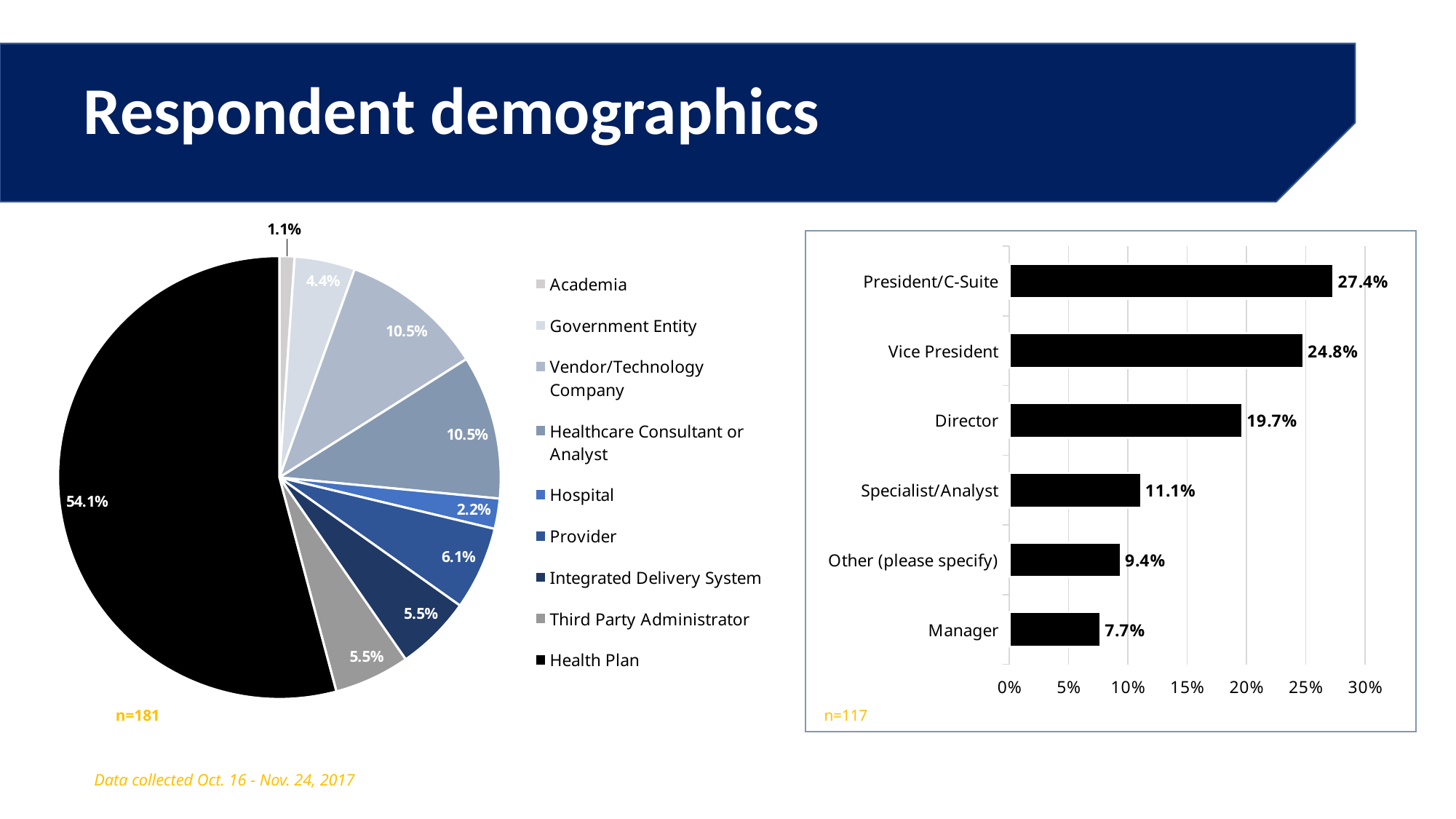
What kind of chart is shown on the right side of the slide? Bar chart In the bar chart on the right, what is the difference between President/C-Suite and Vice President? 2.6% In the bar chart on the right, which category has the highest value? President/C-Suite In the bar chart on the right, how many categories are shown? 6 In the bar chart on the right, which category has the lowest value? Manager In the pie chart on the left, what share of respondents are from a Health Plan? 54.1% In the pie chart on the left, how many categories does the legend list? 9 In the pie chart on the left, which category has the largest slice? Health Plan In the pie chart on the left, which category has the smallest slice? Academia In the pie chart on the left, which is larger: Provider or Hospital? Provider In the bar chart on the right, what is the value for Director? 19.7% In the pie chart on the left, what percentage of respondents are from Academia? 1.1%